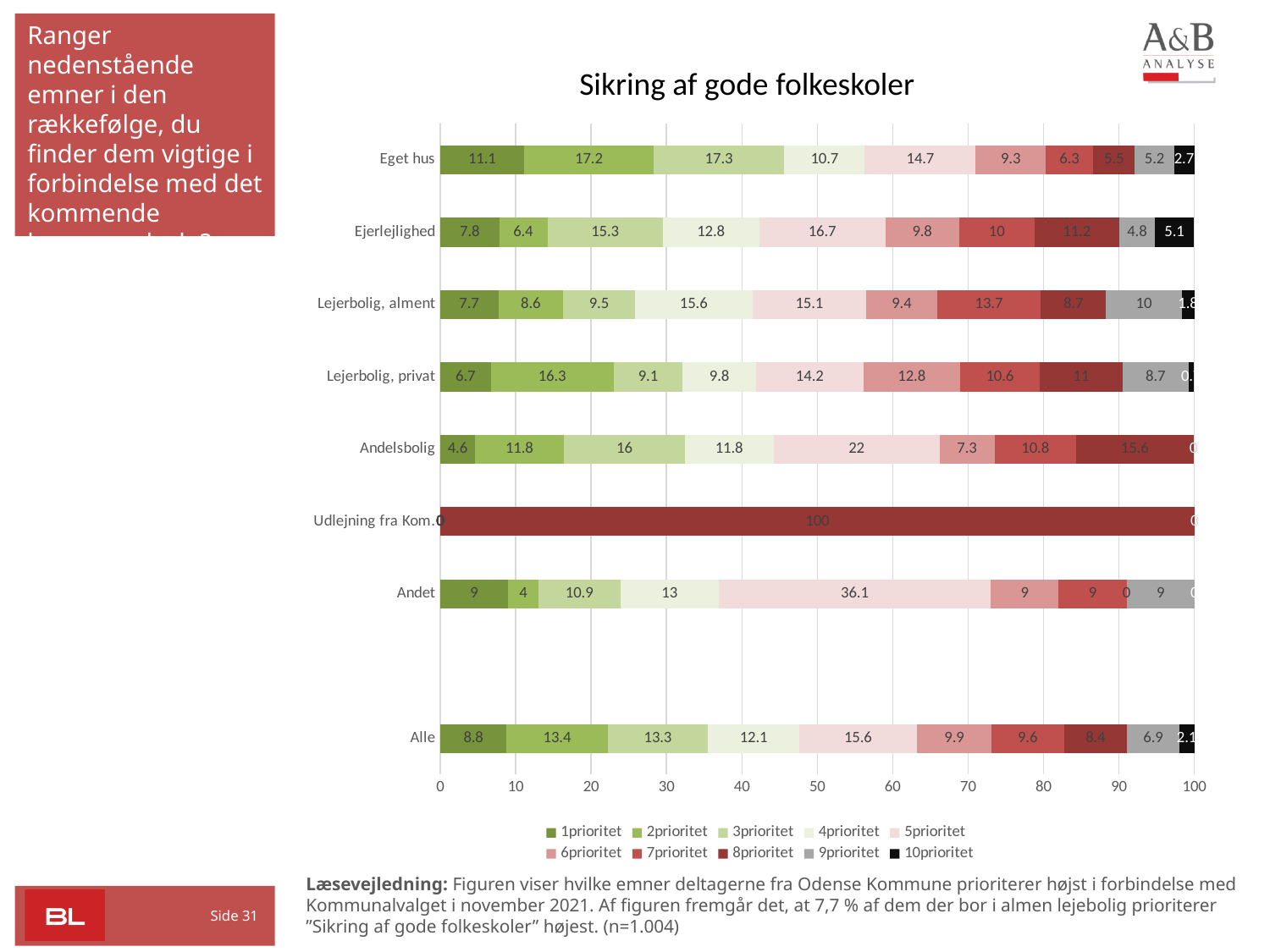
What is the difference between the 2prioritet values for Eget hus and Ejerlejlighed? 10.8 Which category has the highest 1prioritet value? Eget hus Which is larger, the 5prioritet value for Andelsbolig or for Alle? Andelsbolig Which category has the lowest 1prioritet value? Udlejning fra Kom. What is the 8prioritet value for Udlejning fra Kom.? 100 What is the 1prioritet value for Lejerbolig, alment? 7.7 How many series does the legend list? 10 What is the title of the chart? Sikring af gode folkeskoler How many categories are shown on the vertical axis of the chart? 8 What type of chart is shown on the slide? Stacked bar chart What is the 1prioritet value for Eget hus? 11.1 What is the 5prioritet value for Andet? 36.1